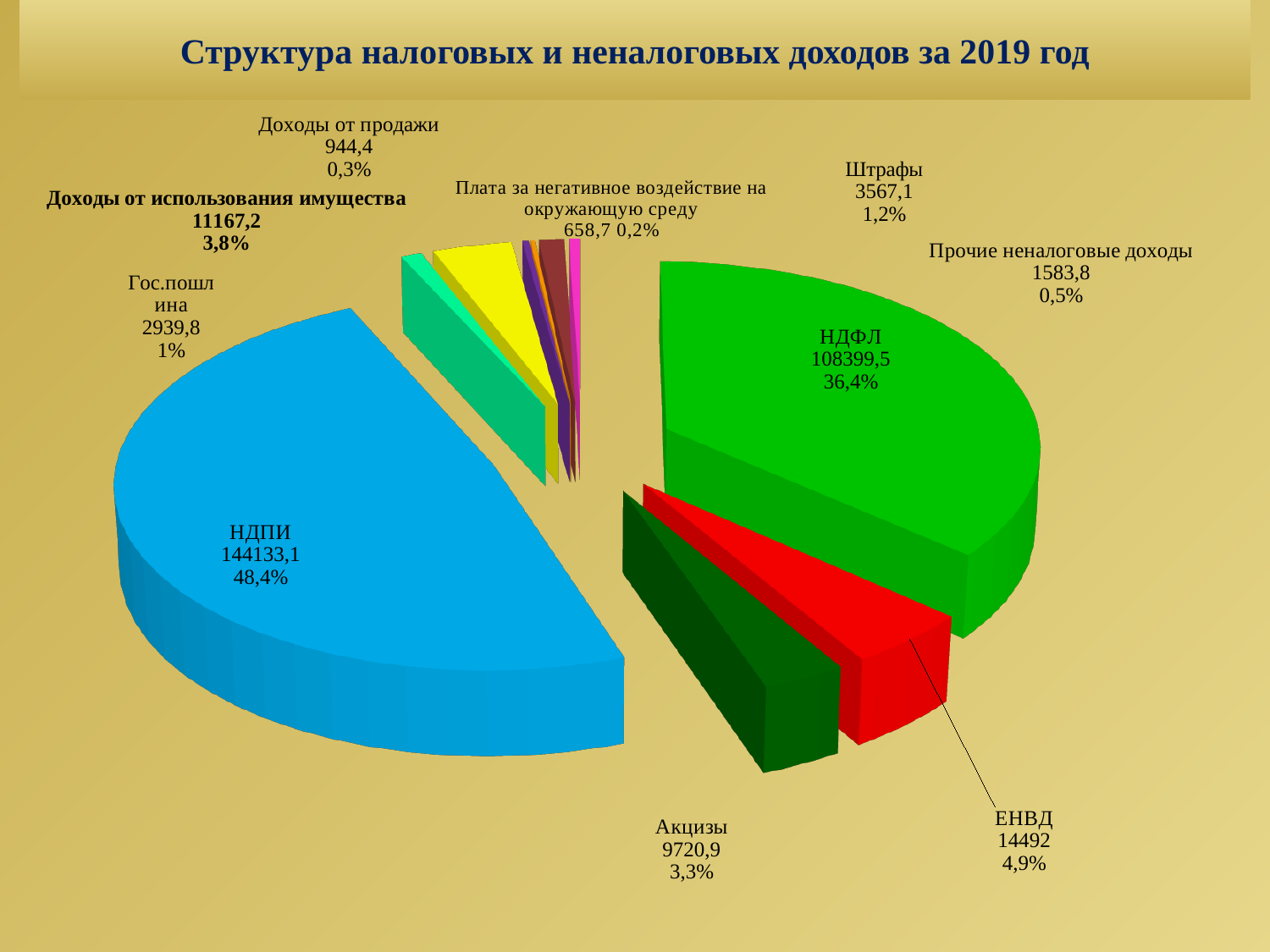
Which category has the smallest slice of the pie? Плата за негативное воздействие на окружающую среду Which category has the largest slice of the pie? НДПИ What kind of chart is shown on the slide? Pie chart What percentage is shown for Акцизы? 3,3% What is the difference between the values for НДПИ and НДФЛ? 35733,6 What share of the pie does НДФЛ represent? 36,4% What is the title of the chart? Структура налоговых и неналоговых доходов за 2019 год Which is larger, Штрафы or Гос.пошлина? Штрафы How many categories are shown in the pie chart? 10 What is the value shown for ЕНВД? 14492 What is the value shown for НДПИ? 144133,1 What is the value shown for Доходы от использования имущества? 11167,2